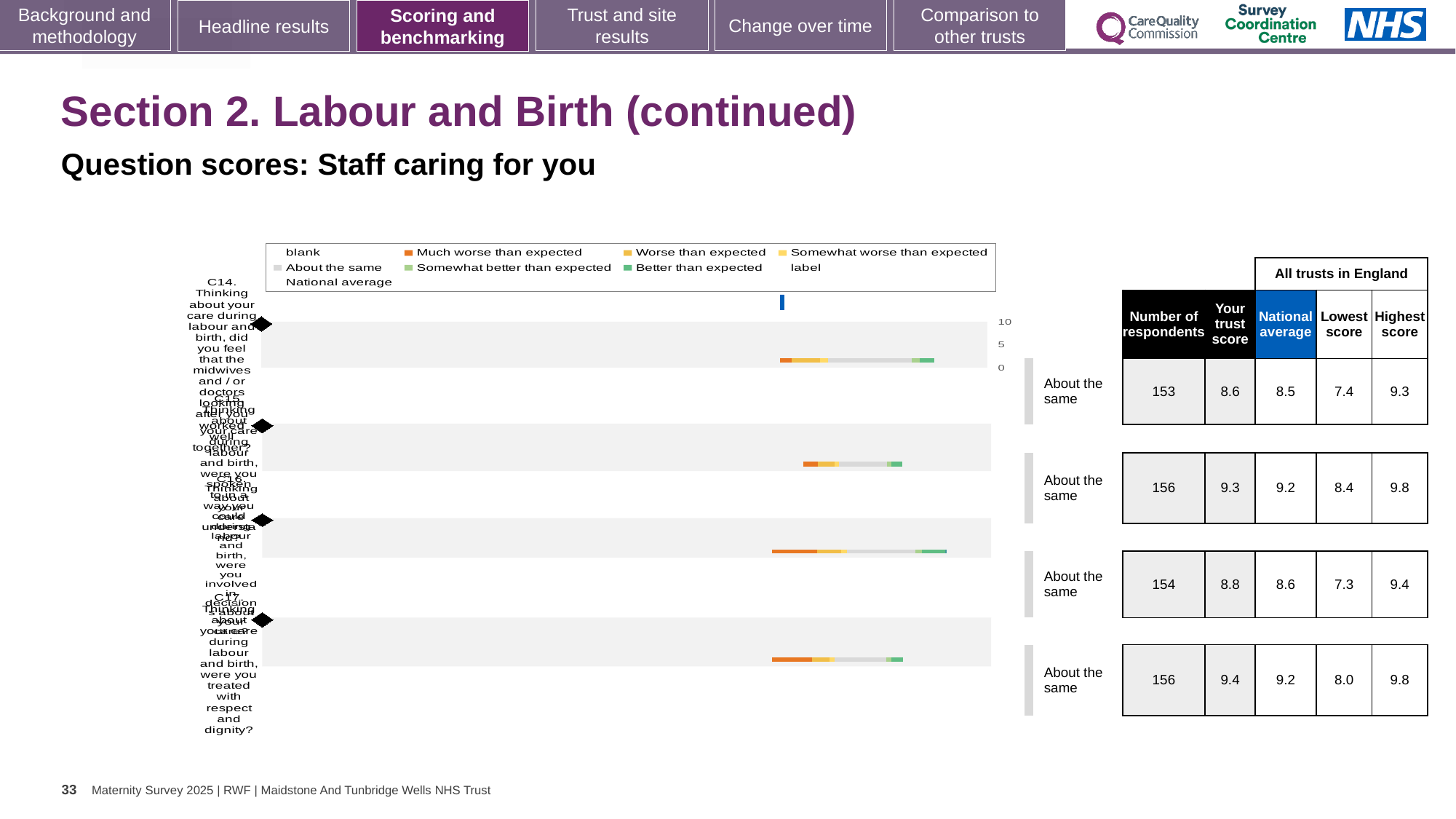
What is the national average for the last question, C17 (treated with respect and dignity)? 9.2 For the second row, which is larger: the trust score or the national average? the trust score (9.3) How many respondents answered question C14? 153 What benchmark category is shown for the first row (C14)? About the same What kind of chart is shown on the slide? bar chart In the chart legend, what colour represents 'About the same'? grey What is the 'Your trust score' for question C14 (the first row)? 8.6 For question C14, what is the difference between the trust score and the national average? 0.1 Which row has the lowest 'Your trust score'? the first row (C14), 8.6 How many questions (bars) are plotted in the chart? 4 Which row has the highest 'Your trust score'? the fourth row (C17), 9.4